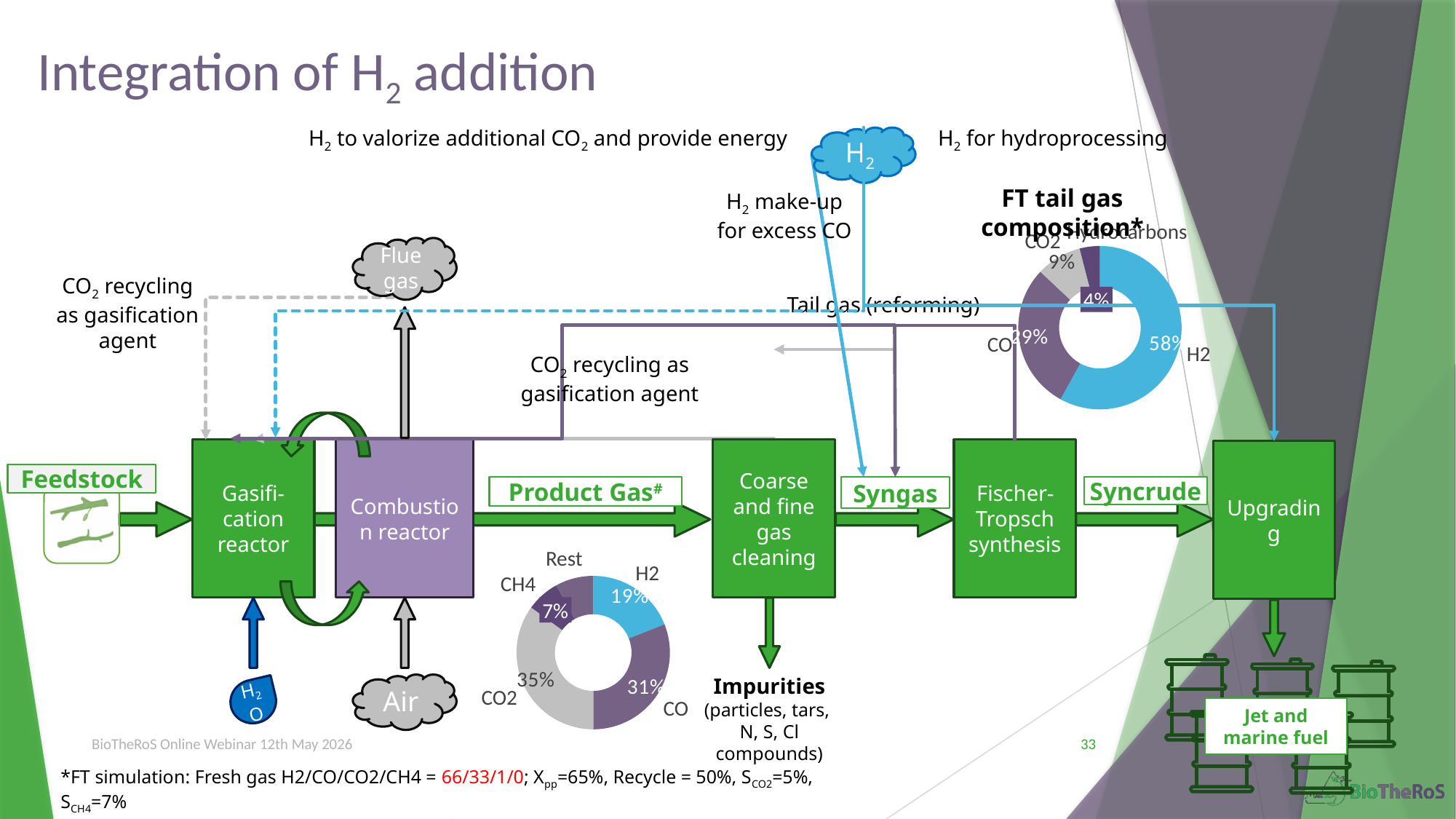
What kind of chart is the FT tail gas composition chart? Doughnut chart How many slices does the FT tail gas composition chart have? 4 In the FT tail gas composition chart, what share is H2? 58% In the FT tail gas composition chart, what share is CO2? 9% In the product gas composition chart below the Product Gas arrow, what share is CO? 31% In the FT tail gas composition chart, what is the difference between the H2 share and the CO share? 29% In the product gas composition chart below the Product Gas arrow, what share is CO2? 35% In the product gas composition chart below the Product Gas arrow, which is larger, the H2 share or the CO share? CO In the FT tail gas composition chart, which component has the smallest share? Hydrocarbons In the product gas composition chart below the Product Gas arrow, what is the difference between the CO2 share and the CH4 share? 28% In the FT tail gas composition chart, what share is CO? 29% In the FT tail gas composition chart, which component has the largest share? H2